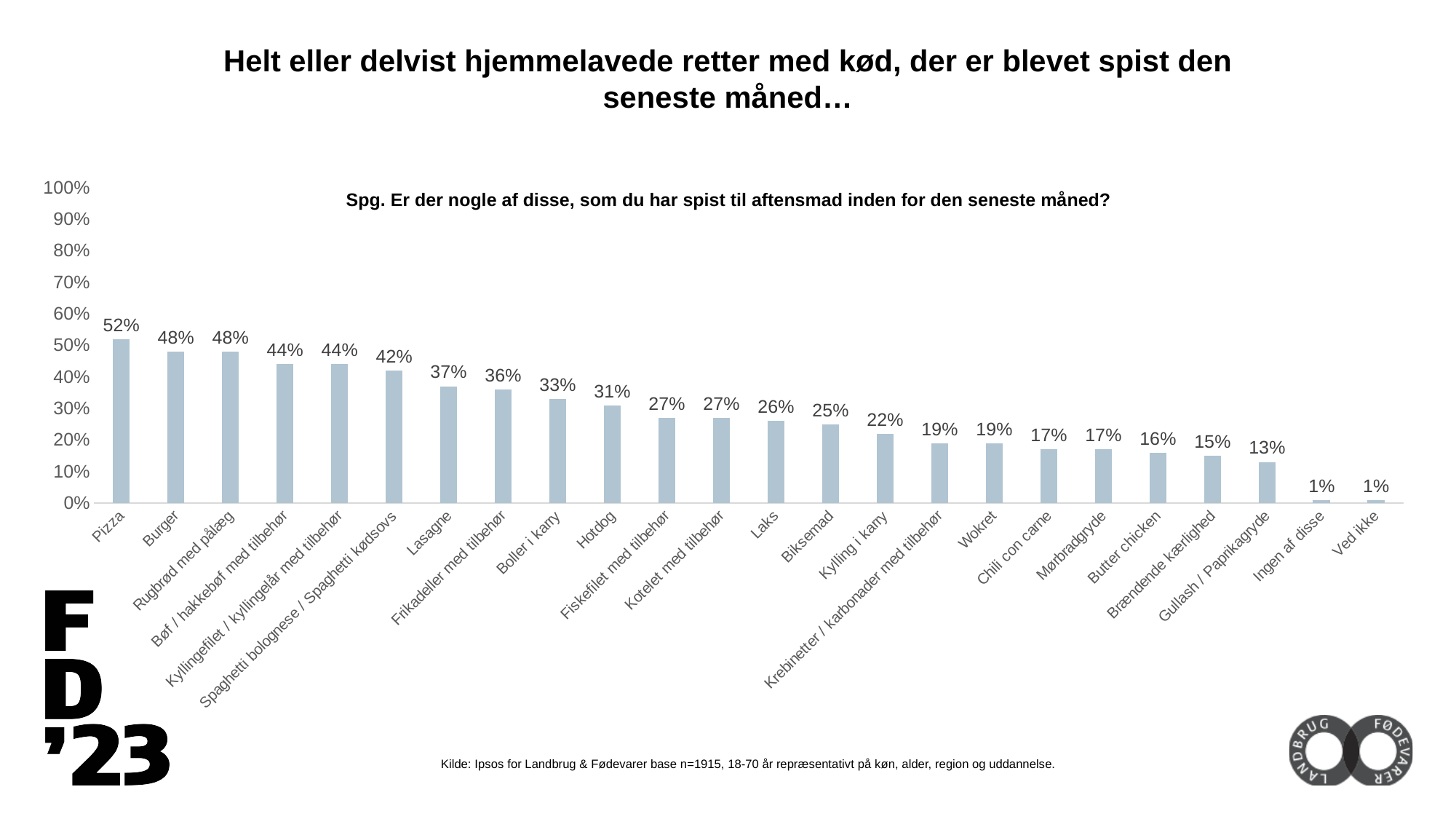
What kind of chart is shown on the slide? Bar chart What is the value shown for Ved ikke? 1% Is the value for Boller i karry greater or less than 30%? greater Which dish has the highest value in the chart? Pizza What is the value shown for Lasagne? 37% What percentage of respondents ate Pizza in the last month? 52% What is the value shown for Butter chicken? 16% Do the values generally rise or fall from left to right along the x axis? Fall Which is larger, the value for Laks or the value for Biksemad? Laks What is the difference between the values for Pizza and Hotdog? 21 percentage points How many categories are shown on the x axis? 24 Which category has the lowest value among the dishes (excluding 'Ingen af disse' and 'Ved ikke')? Gullash / Paprikagryde